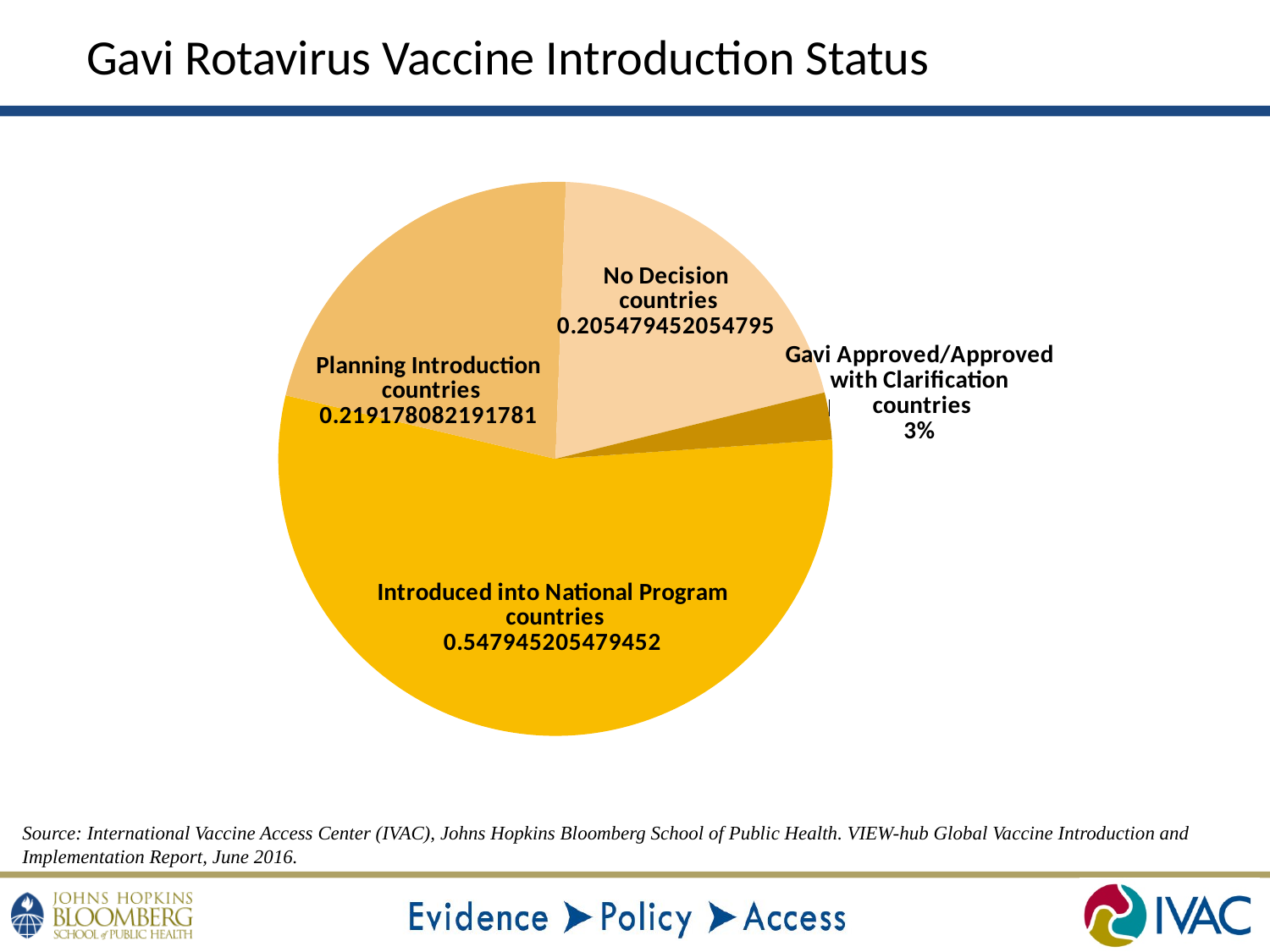
What value is shown for Introduced into National Program countries? 0.547945205479452 Which slice of the pie is shown in the darkest yellow-gold colour? Gavi Approved/Approved with Clarification countries What is the title of the chart on the slide? Gavi Rotavirus Vaccine Introduction Status What value is shown for Gavi Approved/Approved with Clarification countries? 3% What value is shown for Planning Introduction countries? 0.219178082191781 Which category has the largest slice of the pie? Introduced into National Program countries Which category has the smallest slice of the pie? Gavi Approved/Approved with Clarification countries Which is larger, the value for Introduced into National Program countries or the value for Planning Introduction countries? Introduced into National Program countries What type of chart is shown on the slide? pie chart How many slices does the pie chart have? 4 What value is shown for No Decision countries? 0.205479452054795 Which is larger, the value for Planning Introduction countries or the value for No Decision countries? Planning Introduction countries